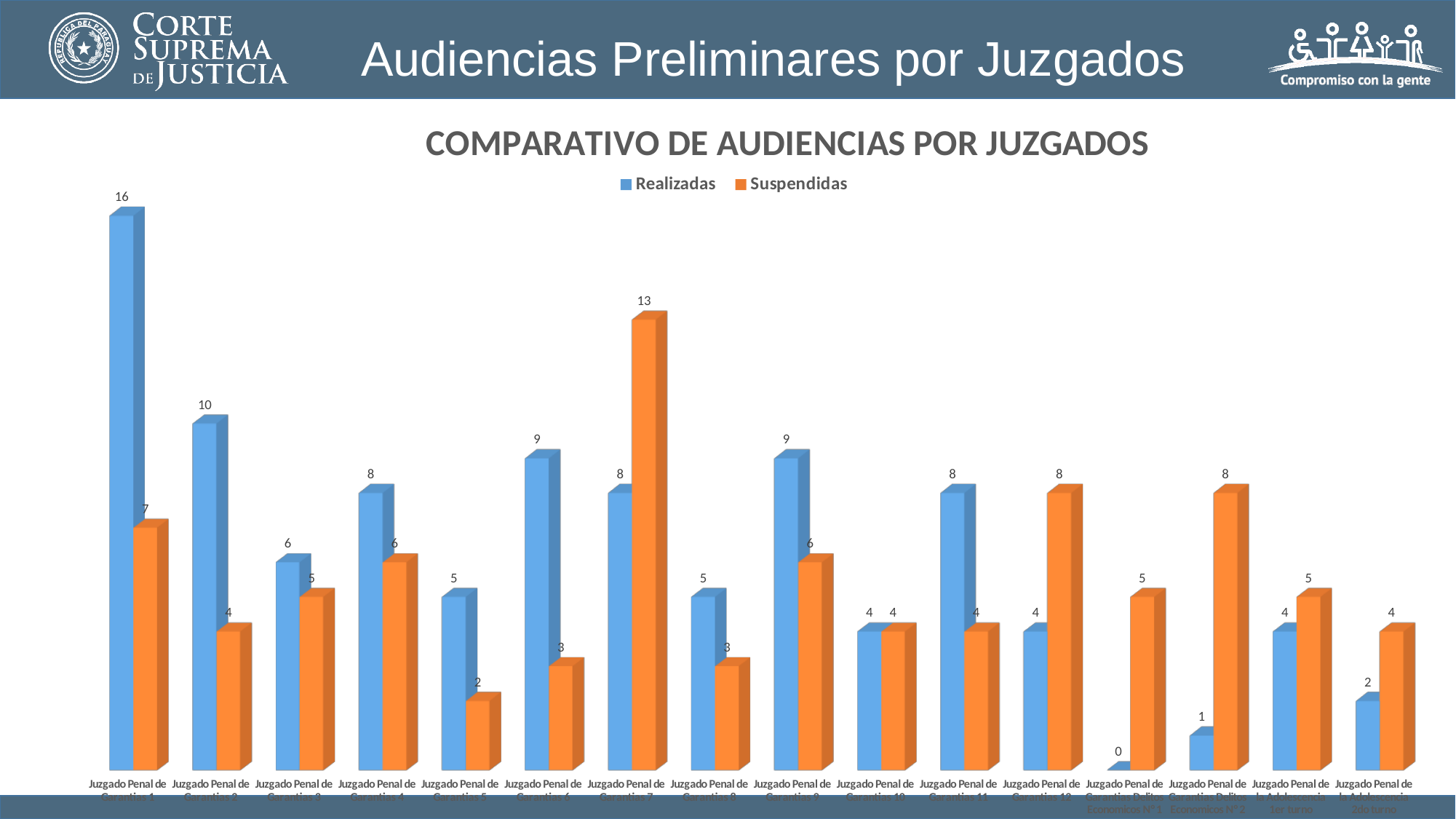
Which juzgado has the highest Suspendidas value? Juzgado Penal de Garantías 7 What is the difference between the Realizadas and Suspendidas values for Juzgado Penal de Garantías 1? 9 What is the title of the chart? COMPARATIVO DE AUDIENCIAS POR JUZGADOS What is the Realizadas value for Juzgado Penal de Garantías 1? 16 How many series does the legend list? 2 What is the Suspendidas value for Juzgado Penal de Garantías 7? 13 Which juzgado has the highest Realizadas value? Juzgado Penal de Garantías 1 Which is larger for Juzgado Penal de Garantías 12: Realizadas or Suspendidas? Suspendidas How many juzgados (categories) are shown on the chart? 16 What is the Realizadas value for Juzgado Penal de Garantías 6? 9 What kind of chart is shown on the slide? Bar chart Which juzgado has the lowest Realizadas value? Juzgado Penal de Garantías Delitos Económicos N° 1